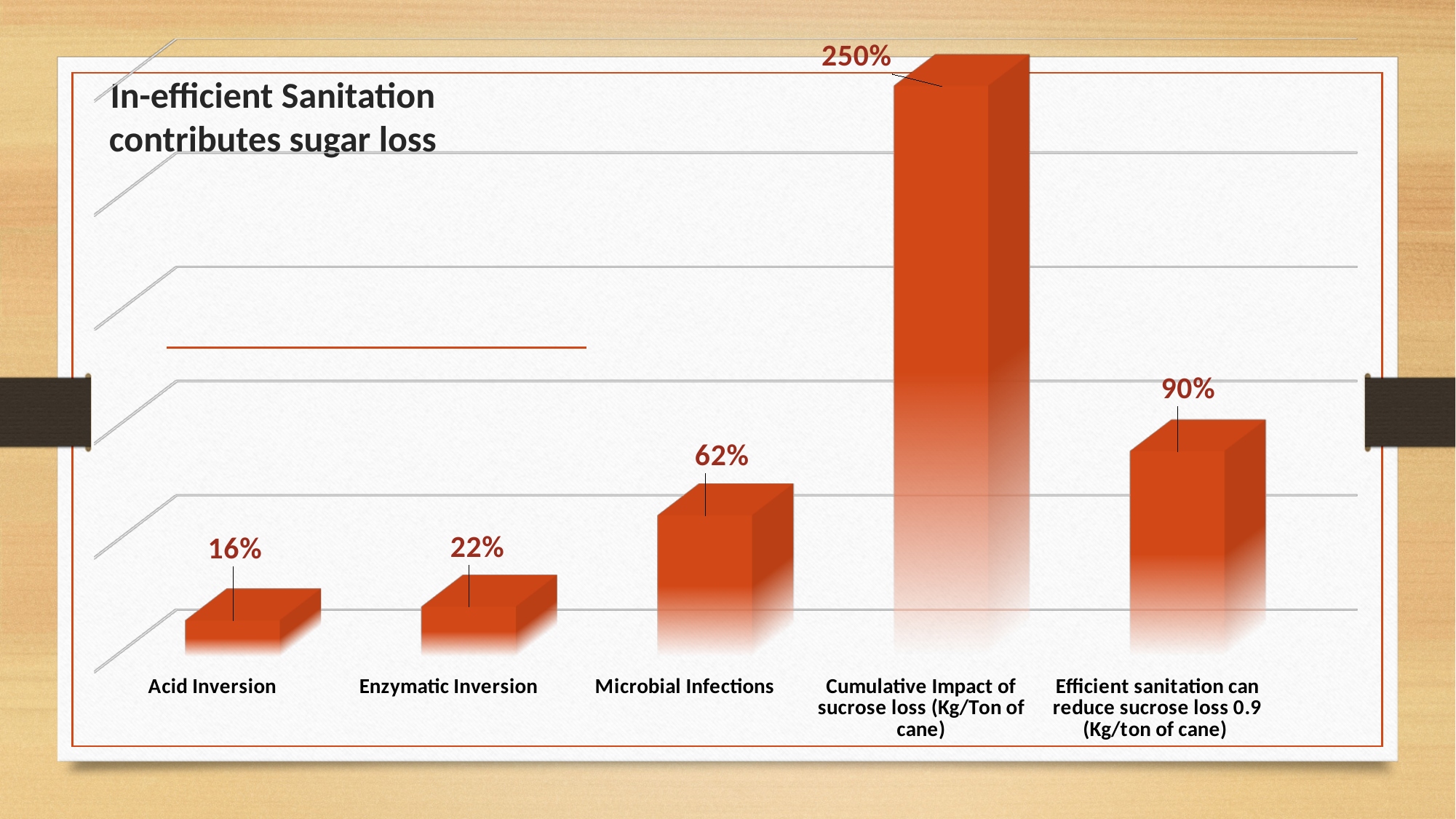
What is the value for Efficient sanitation can reduce sucrose loss 0.9 (Kg/ton of cane)? 90% Which category has the lowest value? Acid Inversion What is the value for Enzymatic Inversion? 22% Which category has the highest value? Cumulative Impact of sucrose loss (Kg/Ton of cane) What is the value for Acid Inversion? 16% How many categories are shown on the chart? 5 Which is larger, the value for Efficient sanitation can reduce sucrose loss 0.9 (Kg/ton of cane) or the value for Microbial Infections? Efficient sanitation can reduce sucrose loss 0.9 (Kg/ton of cane) What is the title of the chart? In-efficient Sanitation contributes sugar loss What is the value for Microbial Infections? 62% What kind of chart is shown on the slide? Bar chart What is the value for Cumulative Impact of sucrose loss (Kg/Ton of cane)? 250% What is the difference between the values for Microbial Infections and Enzymatic Inversion? 40%